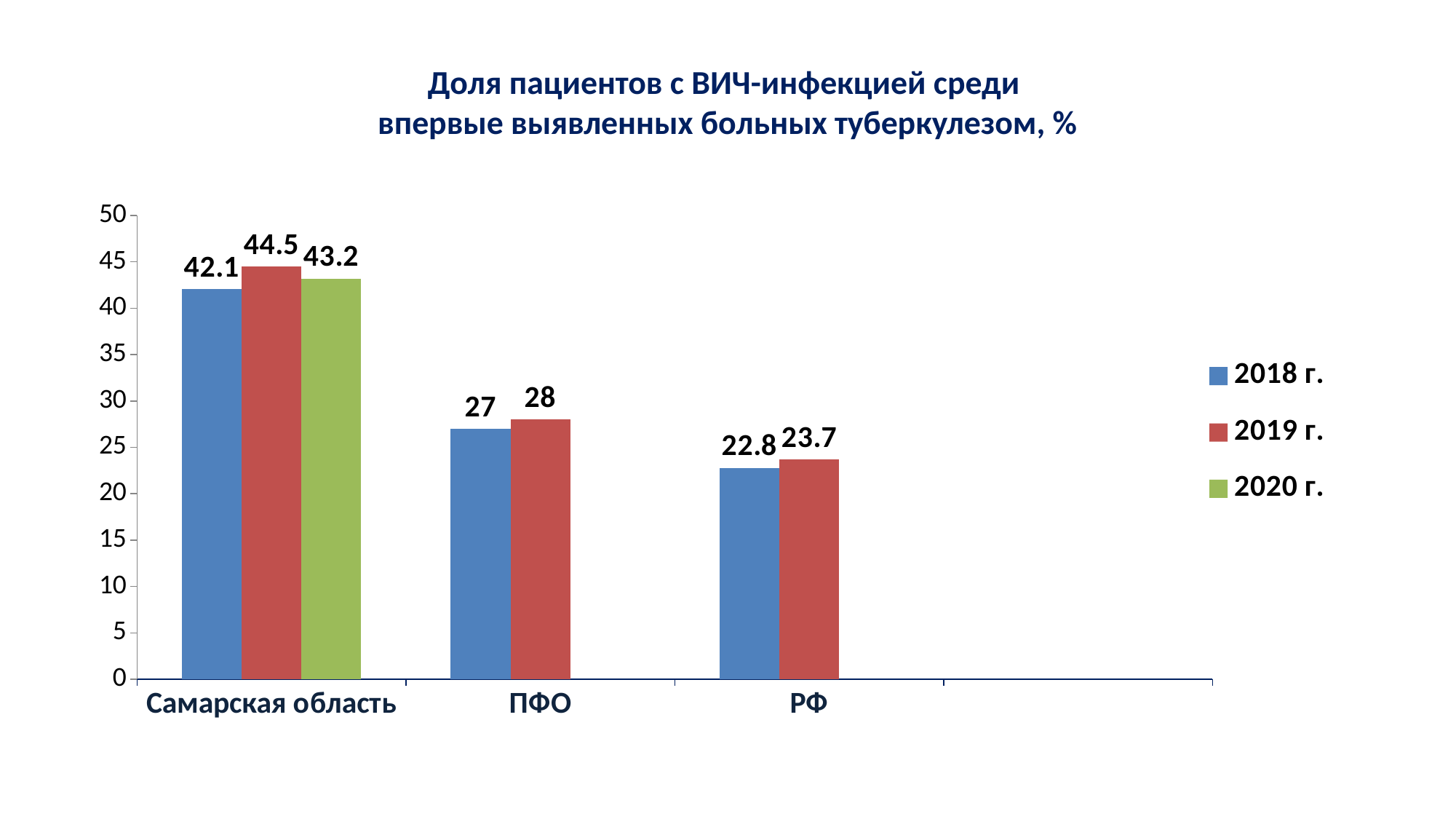
How many series does the legend list? 3 What is the value for ПФО in 2019 г.? 28 Which category has the highest value in 2019 г.? Самарская область What kind of chart is shown on the slide? bar chart What is the value for РФ in 2018 г.? 22.8 Is the 2018 г. value for ПФО greater or less than 30? less What is the value for Самарская область in 2020 г.? 43.2 How many categories are shown on the x axis? 3 What is the difference between the 2019 г. and 2018 г. values for Самарская область? 2.4 What is the value for Самарская область in 2018 г.? 42.1 Which category has the lowest value in 2018 г.? РФ Which is larger: the 2019 г. value for ПФО or the 2019 г. value for РФ? ПФО